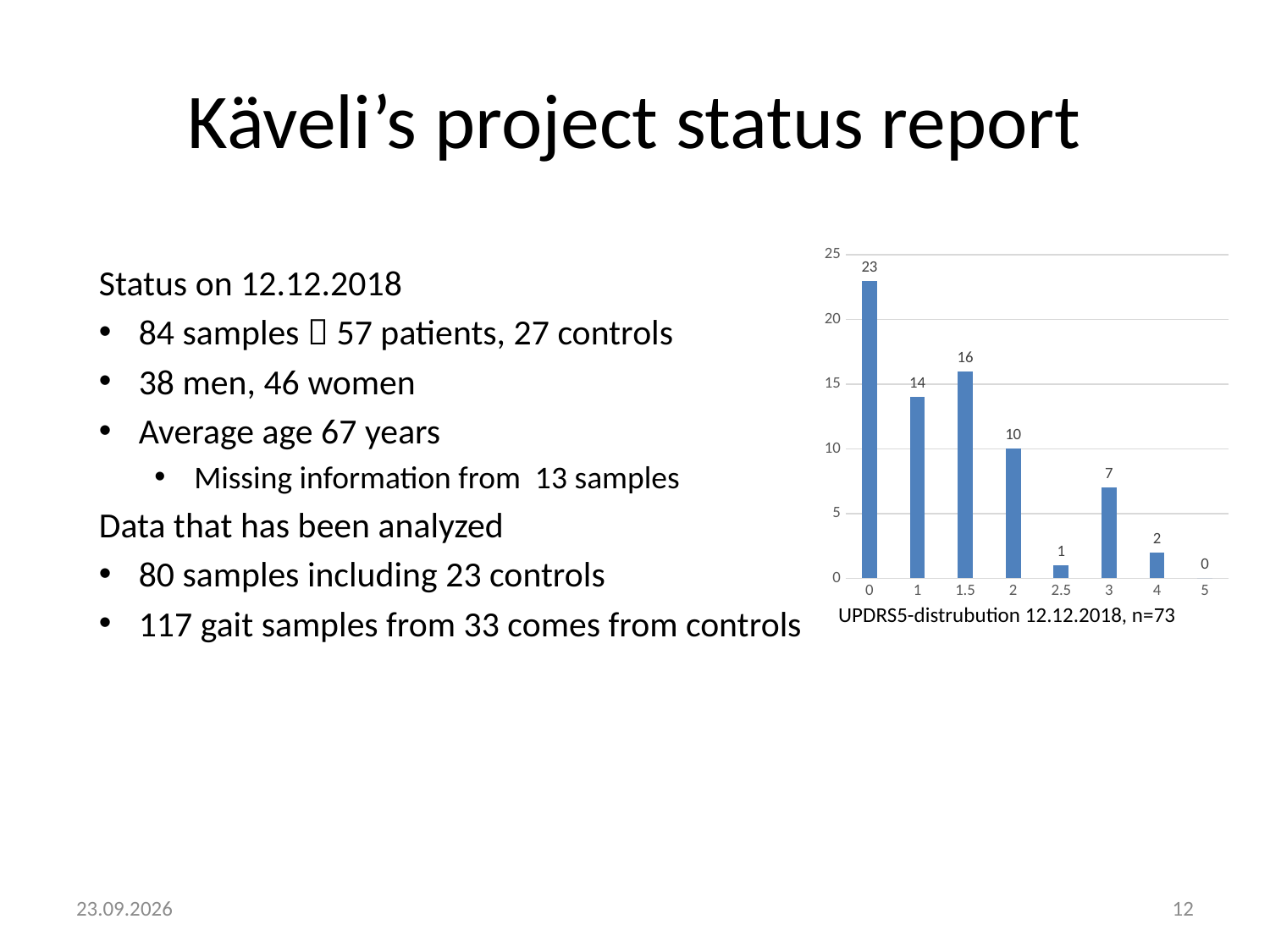
What is the value for category 0 in the UPDRS5 distribution chart? 23 What kind of chart is shown on the slide? bar chart What is the value for category 3 in the chart? 7 Which is larger, the value for category 1 or the value for category 1.5? 1.5 Is the value for category 2 greater or less than 15? less How many categories are shown on the x axis of the chart? 8 Which category has the highest value in the chart? 0 What is the caption below the chart? UPDRS5-distrubution 12.12.2018, n=73 What is the difference between the values for category 0 and category 1? 9 Which category has the lowest value in the chart? 5 Do the values generally rise or fall from category 0 to category 5? fall What is the value for category 1.5 in the chart? 16